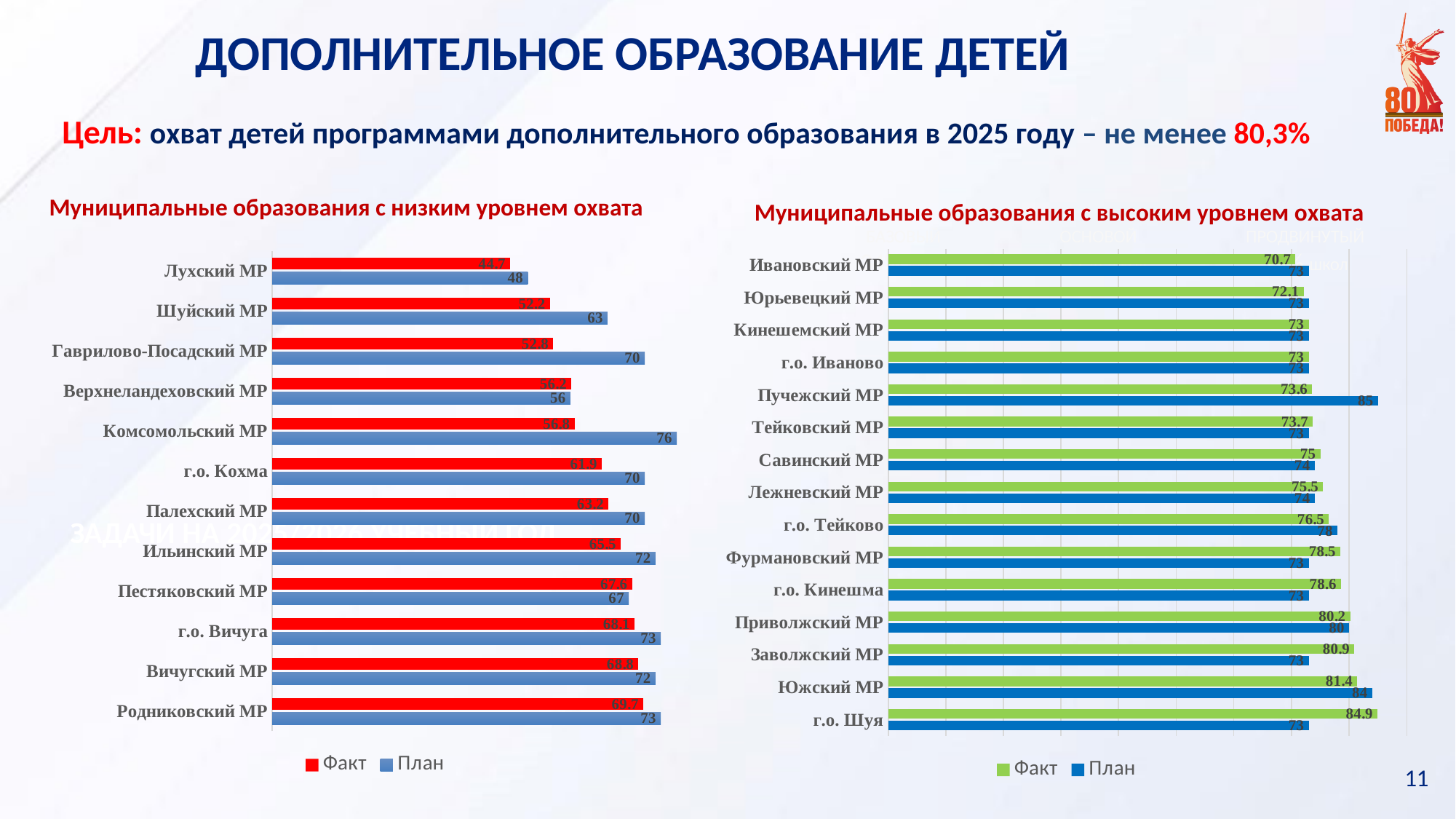
In the chart 'Муниципальные образования с низким уровнем охвата', what is the План value for Комсомольский МР? 76 How many municipalities are shown in the chart 'Муниципальные образования с высоким уровнем охвата'? 15 In the chart 'Муниципальные образования с низким уровнем охвата', which municipality has the highest Факт value? Родниковский МР In the chart 'Муниципальные образования с высоким уровнем охвата', which is larger for Южский МР: Факт or План? План In the chart 'Муниципальные образования с высоким уровнем охвата', what is the Факт value for г.о. Шуя? 84.9 How many municipalities are shown in the chart 'Муниципальные образования с низким уровнем охвата'? 12 How many series does the legend of the chart 'Муниципальные образования с высоким уровнем охвата' list? 2 What type of chart is 'Муниципальные образования с низким уровнем охвата'? Bar chart In the chart 'Муниципальные образования с низким уровнем охвата', which municipality has the lowest План value? Лухский МР In the chart 'Муниципальные образования с высоким уровнем охвата', which municipality has the highest План value? Пучежский МР In the chart 'Муниципальные образования с низким уровнем охвата', what is the difference between the План and Факт values for Гаврилово-Посадский МР? 17.2 In the chart 'Муниципальные образования с низким уровнем охвата', what is the Факт value for Лухский МР? 44.7